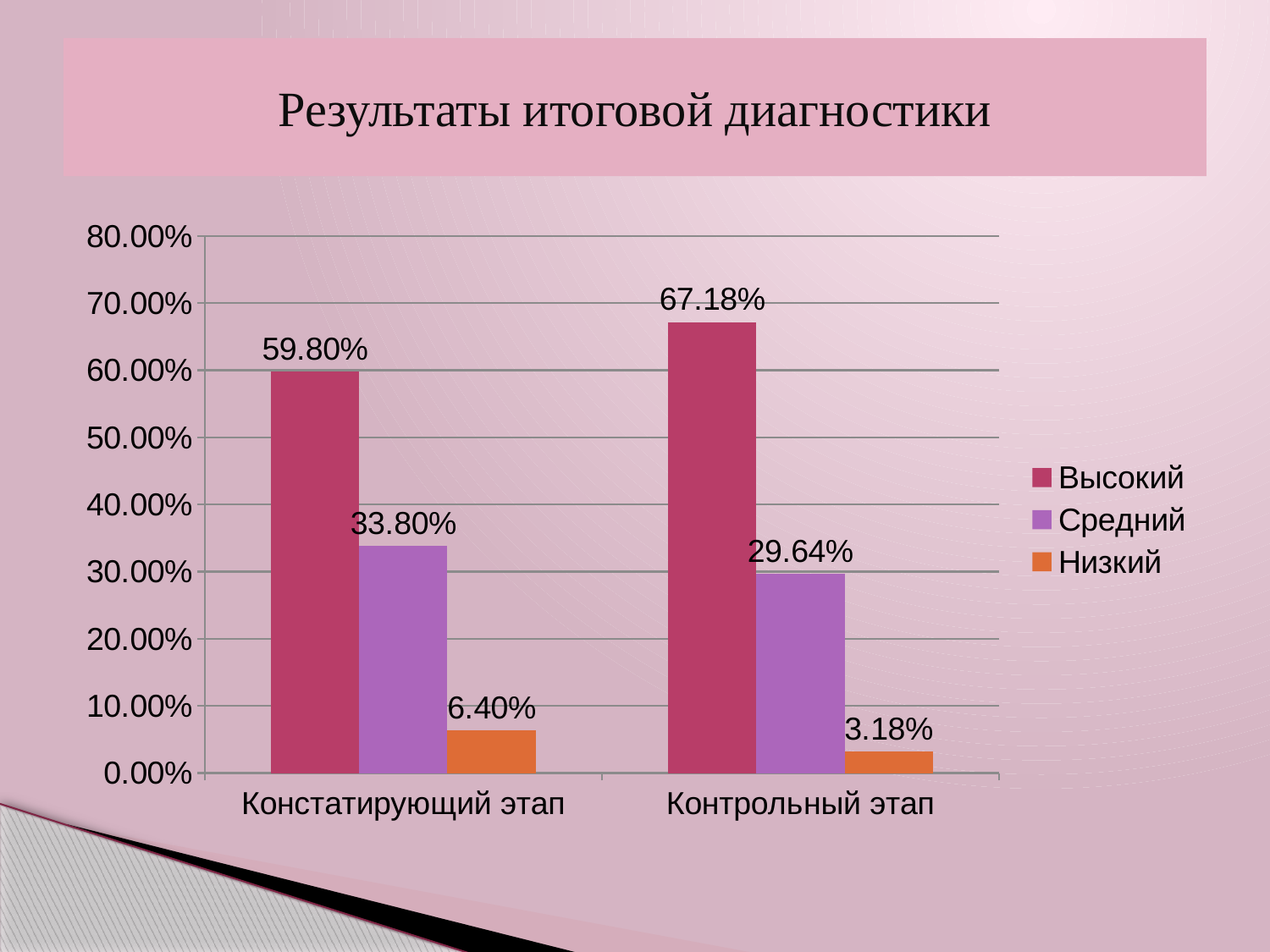
What is the value for Высокий at the Контрольный этап? 67.18% Which series has the lowest value at the Контрольный этап? Низкий What is the title of the slide? Результаты итоговой диагностики What is the value for Высокий at the Констатирующий этап? 59.80% How many series does the legend list? 3 What is the difference between the Высокий values at the Контрольный этап and the Констатирующий этап? 7.38% What kind of chart is shown on the slide? Bar chart Which is larger: Средний at the Констатирующий этап or Средний at the Контрольный этап? Констатирующий этап How many categories are shown on the x axis? 2 What is the value for Низкий at the Констатирующий этап? 6.40% Which series has the highest value at the Констатирующий этап? Высокий What is the value for Средний at the Контрольный этап? 29.64%